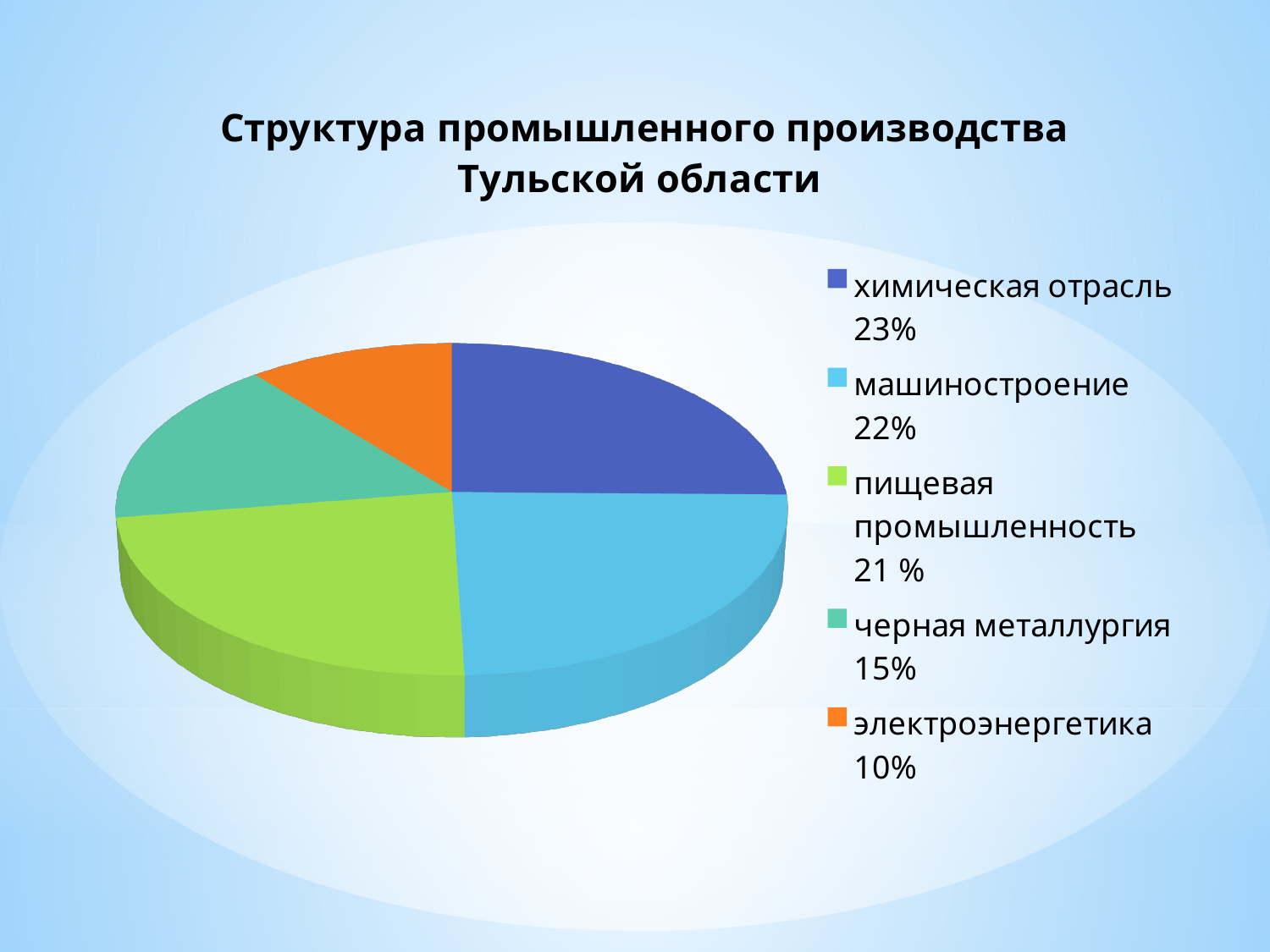
What is the value shown for машиностроение? 22% What is the value shown for пищевая промышленность? 21 % What is the difference between the shares of химическая отрасль and электроэнергетика? 13% What is the value shown for черная металлургия? 15% Which is larger, the share of черная металлургия or the share of электроэнергетика? черная металлургия Which category has the largest share of the pie? химическая отрасль What is the value shown for электроэнергетика? 10% How many categories (slices) does the pie chart have? 5 What type of chart is shown on the slide? pie chart What share of industrial production does химическая отрасль hold? 23% What is the title of the chart? Структура промышленного производства Тульской области Which category has the smallest share of the pie? электроэнергетика